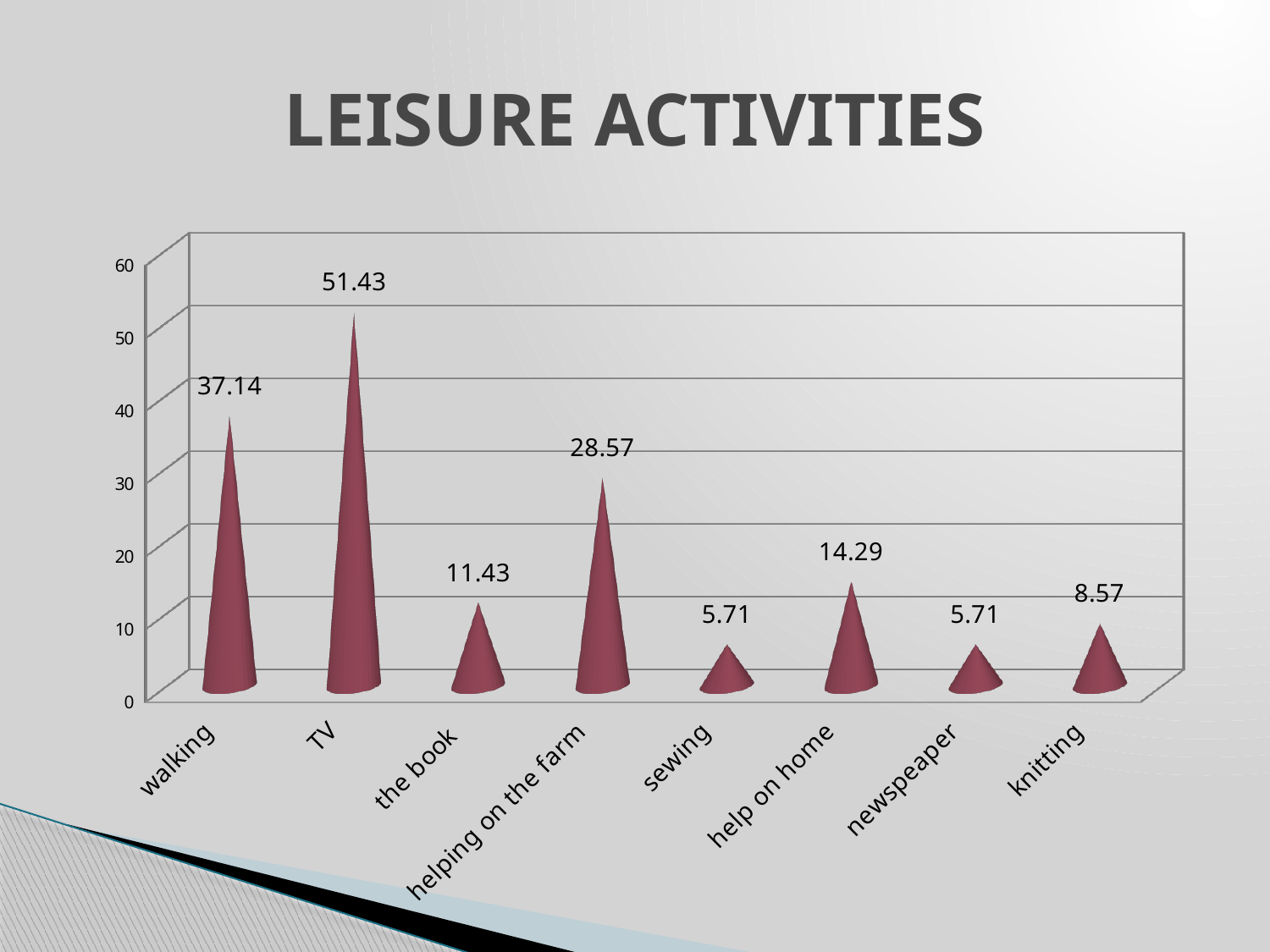
What is the value for helping on the farm? 28.57 Is the value for the book greater or less than 20? less What is the difference between the values for helping on the farm and the book? 17.14 What kind of chart is shown on the slide? bar chart Which category has the highest value? TV What is the value for knitting? 8.57 How many categories are shown on the x axis? 8 What is the difference between the values for TV and walking? 14.29 What is the value for help on home? 14.29 What is the value for TV? 51.43 Which is larger, the value for walking or the value for helping on the farm? walking What is the title of the slide? LEISURE ACTIVITIES